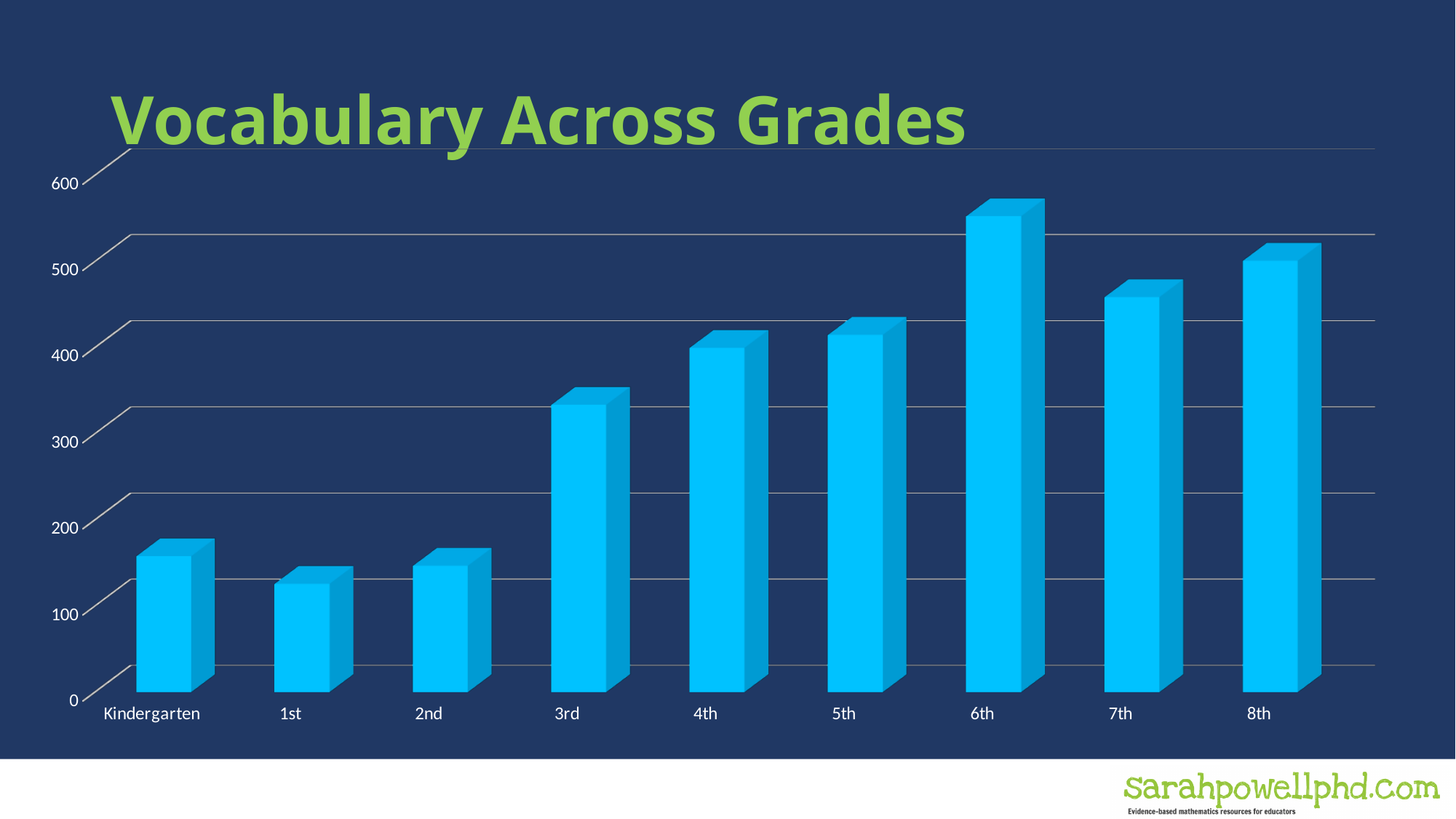
Is the value for 7th grade greater or less than 500? less Is the value for 3rd grade greater or less than 300? greater Which grade has the highest bar? 6th Which grade has the lowest bar? 1st How many grade categories are plotted on the x axis? 9 Which is larger, the value for Kindergarten or the value for 1st grade? Kindergarten Which is larger, the value for 6th grade or the value for 7th grade? 6th Is the value for 1st grade greater or less than 200? less Do the values generally rise or fall from Kindergarten to 8th grade? rise What is the title of the chart? Vocabulary Across Grades What kind of chart is shown on the slide? bar chart